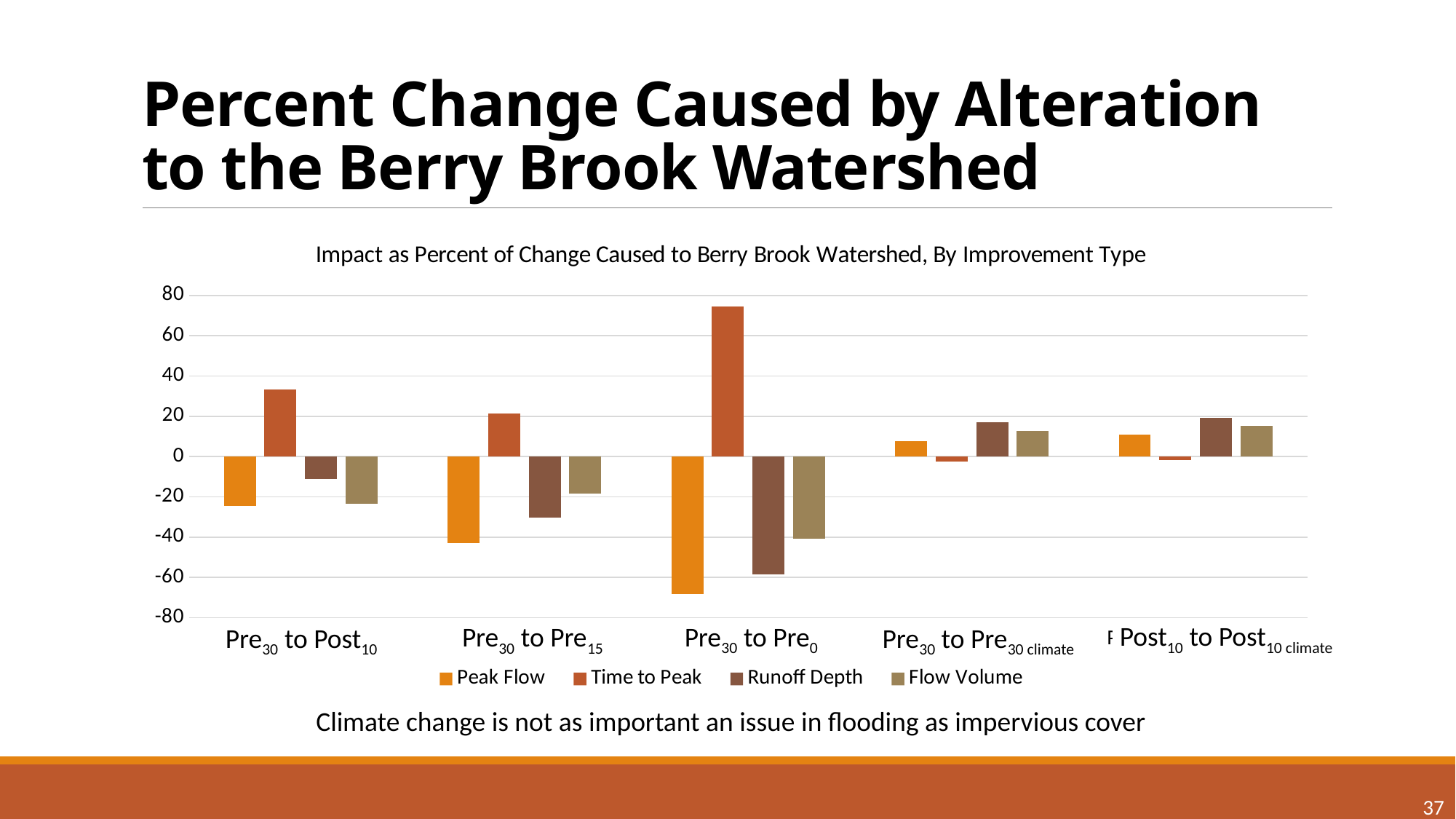
Is the Peak Flow value for Pre30 to Pre0 greater or less than -60? less Is the Time to Peak value for Pre30 to Pre0 greater or less than 60? greater Which category has the lowest Peak Flow value? Pre30 to Pre0 What kind of chart is shown on the slide? Bar chart Which is larger, the Time to Peak value for Pre30 to Post10 or for Pre30 to Pre15? Pre30 to Post10 Is the Time to Peak value for Pre30 to Post10 greater or less than 20? greater Which category has the highest Time to Peak value? Pre30 to Pre0 How many categories are shown on the x axis? 5 What is the title of the chart? Impact as Percent of Change Caused to Berry Brook Watershed, By Improvement Type How many series does the legend list? 4 Which series is shown in the lightest (tan) colour? Flow Volume